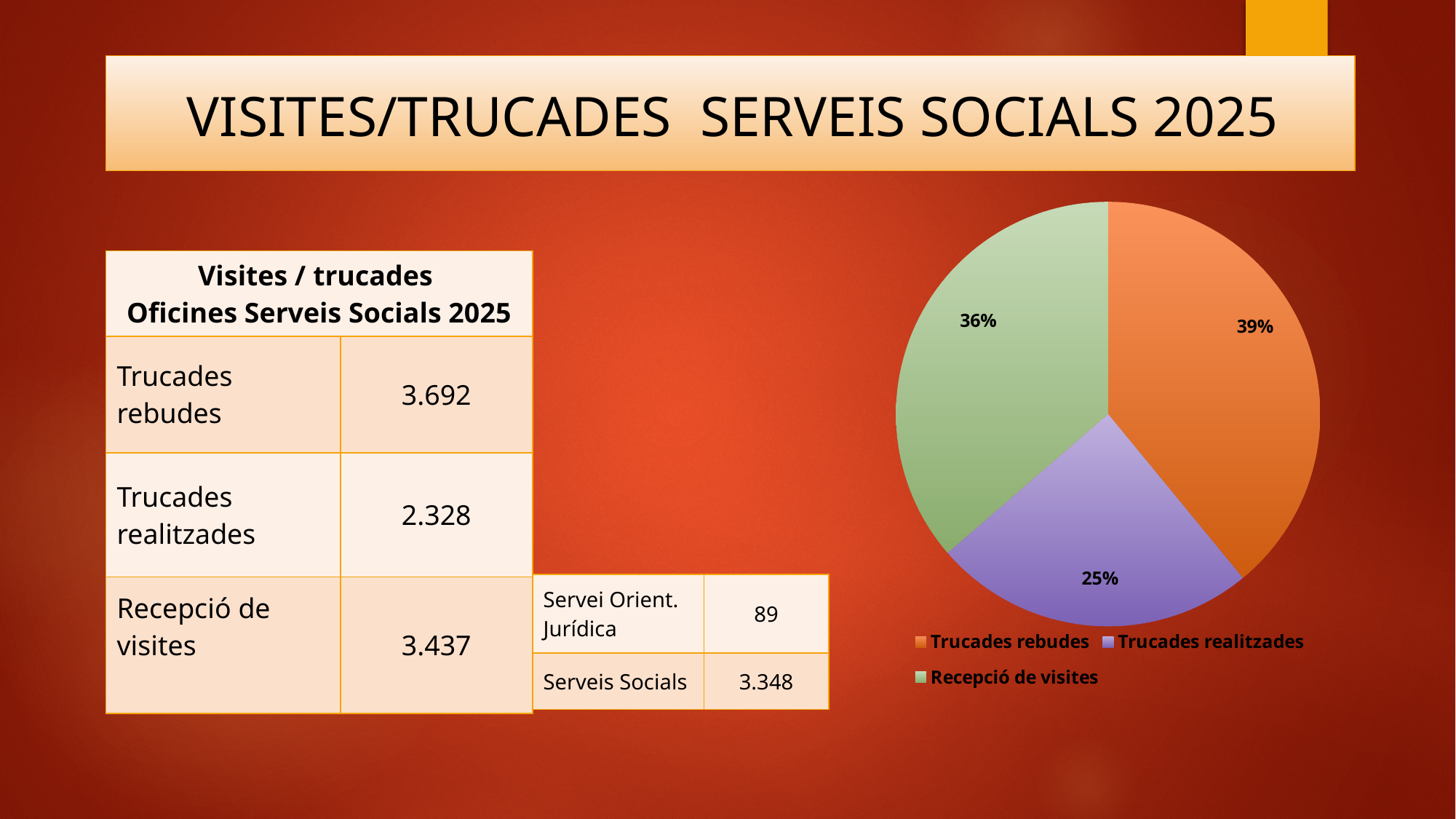
How many slices does the pie chart have? 3 What colour is the Trucades realitzades slice in the pie chart? purple Which category has the smallest slice in the pie chart? Trucades realitzades What share of the pie chart does Trucades rebudes represent? 39% How many entries does the pie chart legend list? 3 What kind of chart is shown on the slide? pie chart What share of the pie chart does Recepció de visites represent? 36% What share of the pie chart does Trucades realitzades represent? 25% Which category has the largest slice in the pie chart? Trucades rebudes What colour is the Recepció de visites slice in the pie chart? green What is the difference in percentage points between the Trucades rebudes slice and the Trucades realitzades slice? 14 Which slice is larger, Recepció de visites or Trucades realitzades? Recepció de visites